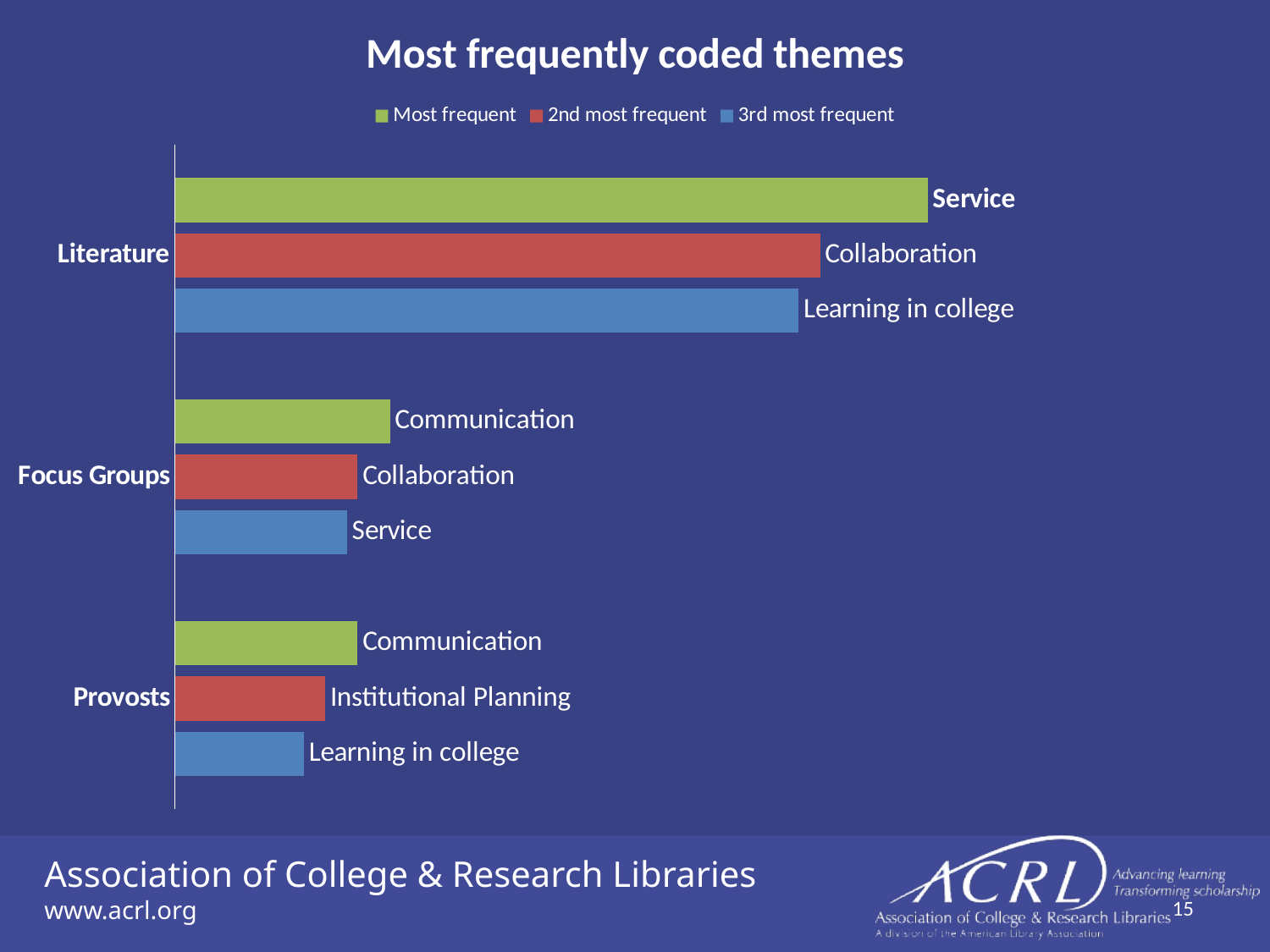
Which is larger: the '3rd most frequent' bar for Focus Groups or the '3rd most frequent' bar for Provosts? Focus Groups Which theme is labelled as the 2nd most frequent for Focus Groups? Collaboration What kind of chart is shown on the slide? bar chart Which theme is labelled as the most frequent for Literature? Service What colour represents the '2nd most frequent' series in the legend? red How many series does the legend list? 3 Which theme is labelled as the 2nd most frequent for Provosts? Institutional Planning Which theme is labelled as the 3rd most frequent for Provosts? Learning in college Which category has the longest bar in the chart? Literature Which is larger: the 'Most frequent' bar for Literature or the 'Most frequent' bar for Focus Groups? Literature How many categories (groups) are shown on the vertical axis? 3 What is the title of the chart? Most frequently coded themes